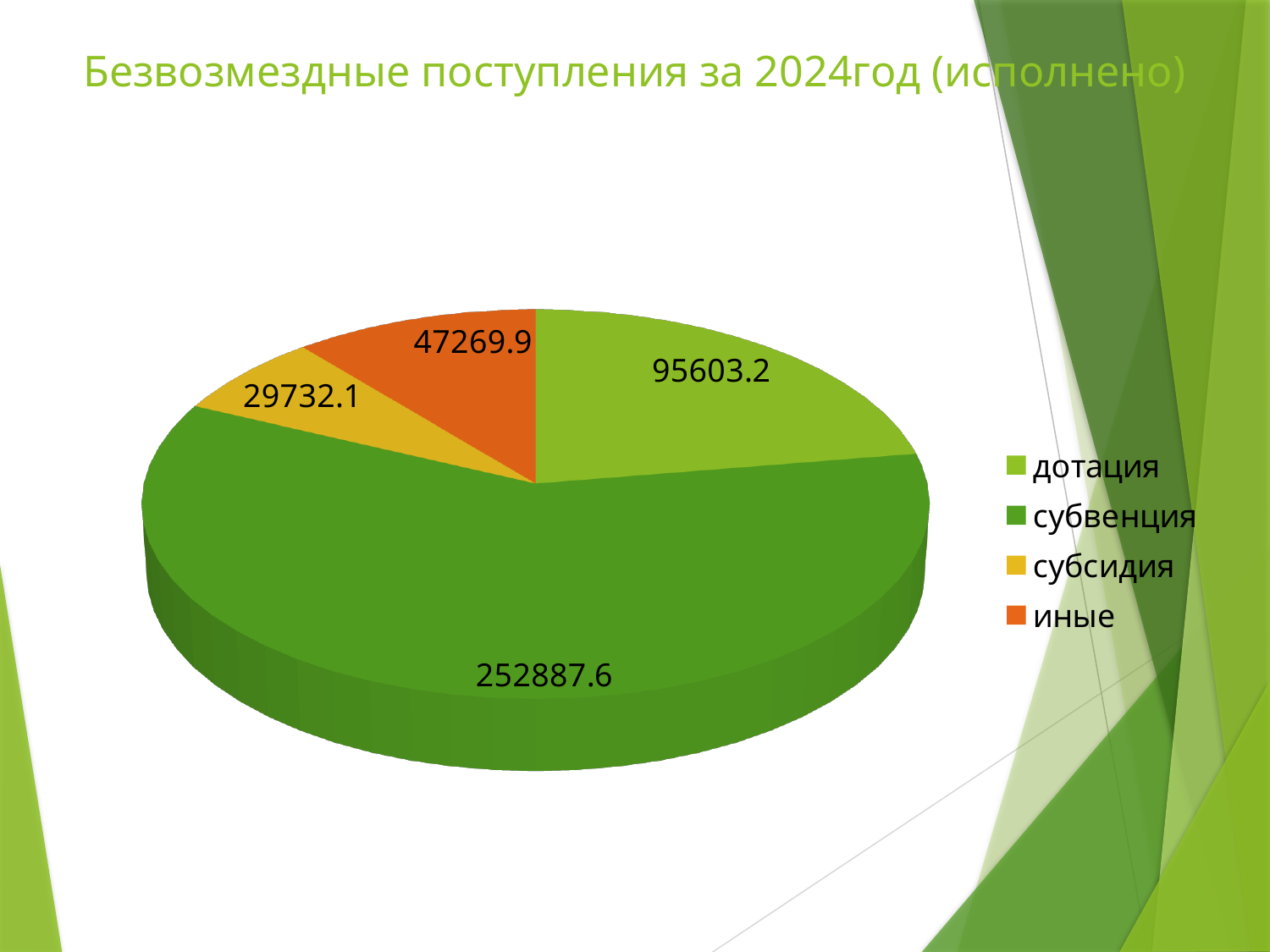
What is the value for иные? 47269.9 What is the value for дотация? 95603.2 What is the title of the chart on the slide? Безвозмездные поступления за 2024год (исполнено) How many categories does the pie chart show? 4 What is the value for субвенция? 252887.6 What type of chart is shown on the slide? Pie chart What is the difference between the values for иные and субсидия? 17537.8 Which category has the largest slice of the pie? субвенция What is the difference between the values for субвенция and дотация? 157284.4 What is the value for субсидия? 29732.1 Which is larger, the value for дотация or the value for иные? дотация Which category has the smallest slice of the pie? субсидия